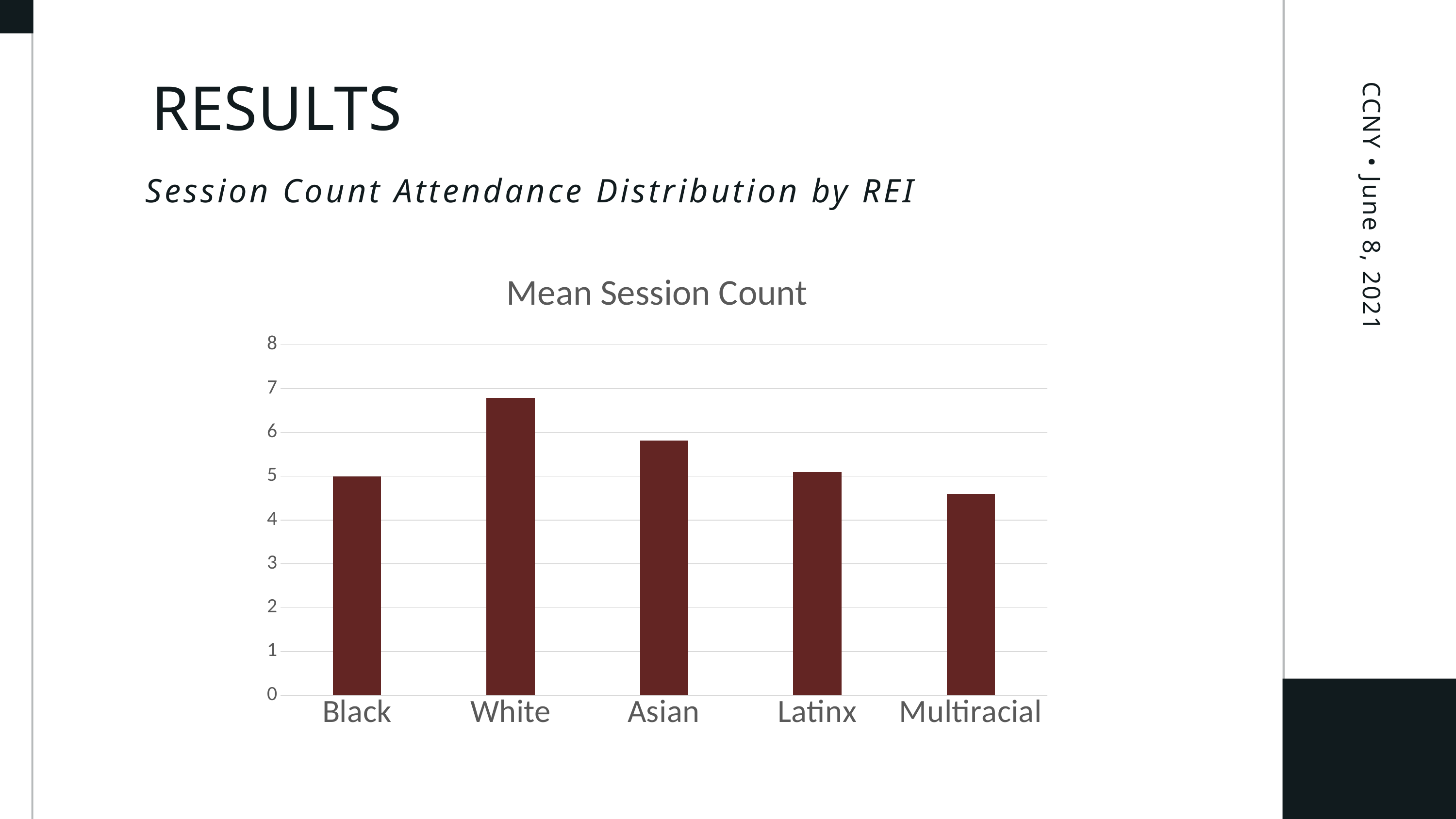
Which category has the lowest mean session count? Multiracial What is the title of the chart? Mean Session Count Which category has the highest mean session count? White Is the value for Multiracial greater or less than 5? less How many categories are shown on the x axis of the chart? 5 What type of chart is shown on the slide? bar chart What is the mean session count for Black? 5 Is the value for Asian greater or less than 5? greater Is the value for White greater or less than 6? greater Which has a higher mean session count, Asian or Latinx? Asian Which has a higher mean session count, White or Asian? White